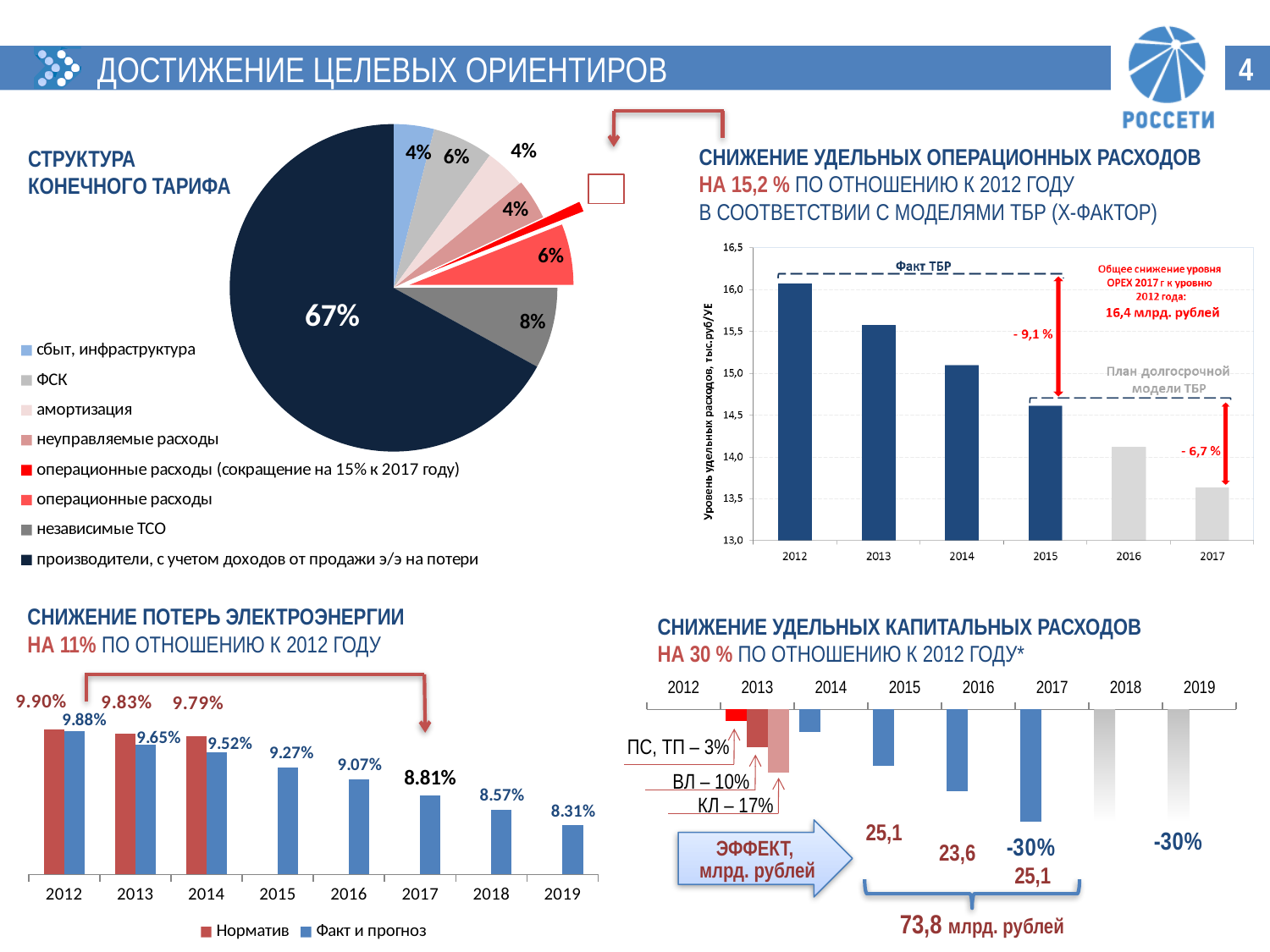
In the chart 'Снижение потерь электроэнергии', do the 'Факт и прогноз' values rise or fall from 2012 to 2019? fall How many entries does the legend of the pie chart 'Структура конечного тарифа' list? 8 In the pie chart 'Структура конечного тарифа', what share is shown for 'независимые ТСО'? 8% In the chart 'Снижение потерь электроэнергии', what is the 'Норматив' value for 2013? 9.83% In the pie chart 'Структура конечного тарифа', what share is shown for 'производители, с учетом доходов от продажи э/э на потери'? 67% In the chart 'Снижение удельных операционных расходов', is the value for 2017 greater or less than 14,0? less How many series does the legend of the chart 'Снижение потерь электроэнергии' list? 2 In the pie chart 'Структура конечного тарифа', which category has the largest slice? производители, с учетом доходов от продажи э/э на потери In the chart 'Снижение удельных операционных расходов', is the value for 2012 greater or less than 16,0? greater In the chart 'Снижение потерь электроэнергии', what is the 'Факт и прогноз' value for 2019? 8.31% How many years are shown on the x axis of the chart 'Снижение удельных операционных расходов'? 6 In the chart 'Снижение потерь электроэнергии', what is the difference between the 'Факт и прогноз' values for 2012 and 2019? 1.57 percentage points